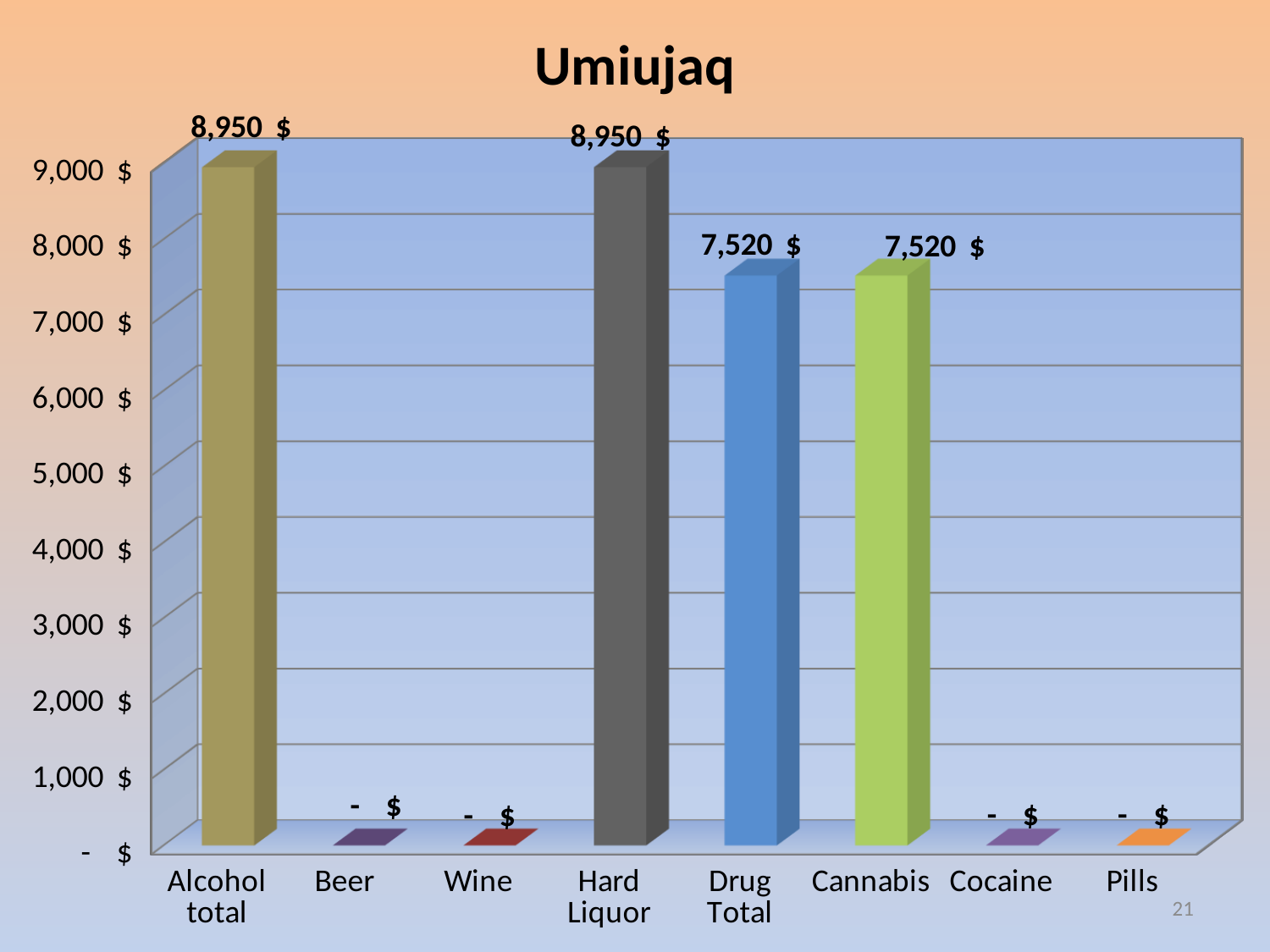
What is the value for Drug Total? 7,520 $ Which categories show a value of - $ (zero)? Beer, Wine, Cocaine, Pills What is the value for Alcohol total? 8,950 $ What is the difference between the Hard Liquor value and the Cannabis value? 1,430 $ What kind of chart is shown on the slide? bar chart What is the difference between the Alcohol total and the Drug Total? 1,430 $ How many categories are shown on the x axis? 8 What is the value for Hard Liquor? 8,950 $ Which is larger, the value for Hard Liquor or the value for Cannabis? Hard Liquor What is the title of the chart? Umiujaq What is the value for Cannabis? 7,520 $ Is the value for Drug Total greater or less than 7,000 $? greater